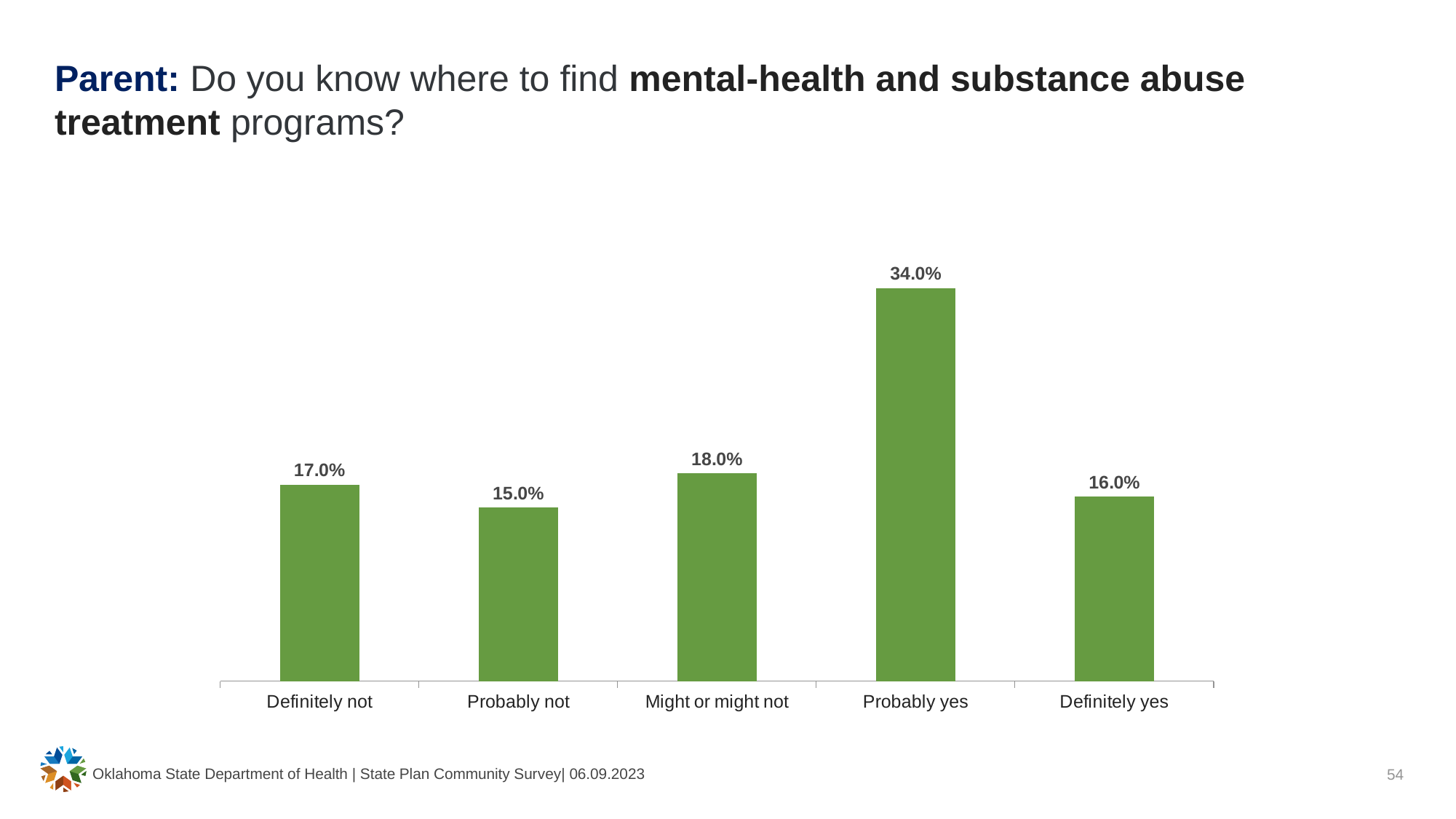
What is the difference between the values for "Might or might not" and "Definitely yes"? 2.0% What percentage of parents answered "Probably yes"? 34.0% What kind of chart is shown on the slide? Bar chart What is the value for "Definitely not"? 17.0% What is the difference between the values for "Probably yes" and "Probably not"? 19.0% What is the value for "Definitely yes"? 16.0% What is the value for "Might or might not"? 18.0% Which is larger, the value for "Definitely not" or the value for "Definitely yes"? Definitely not Which response category has the lowest value? Probably not Which response category has the highest value? Probably yes What colour are the bars in the chart? Green How many response categories are shown on the x axis? 5